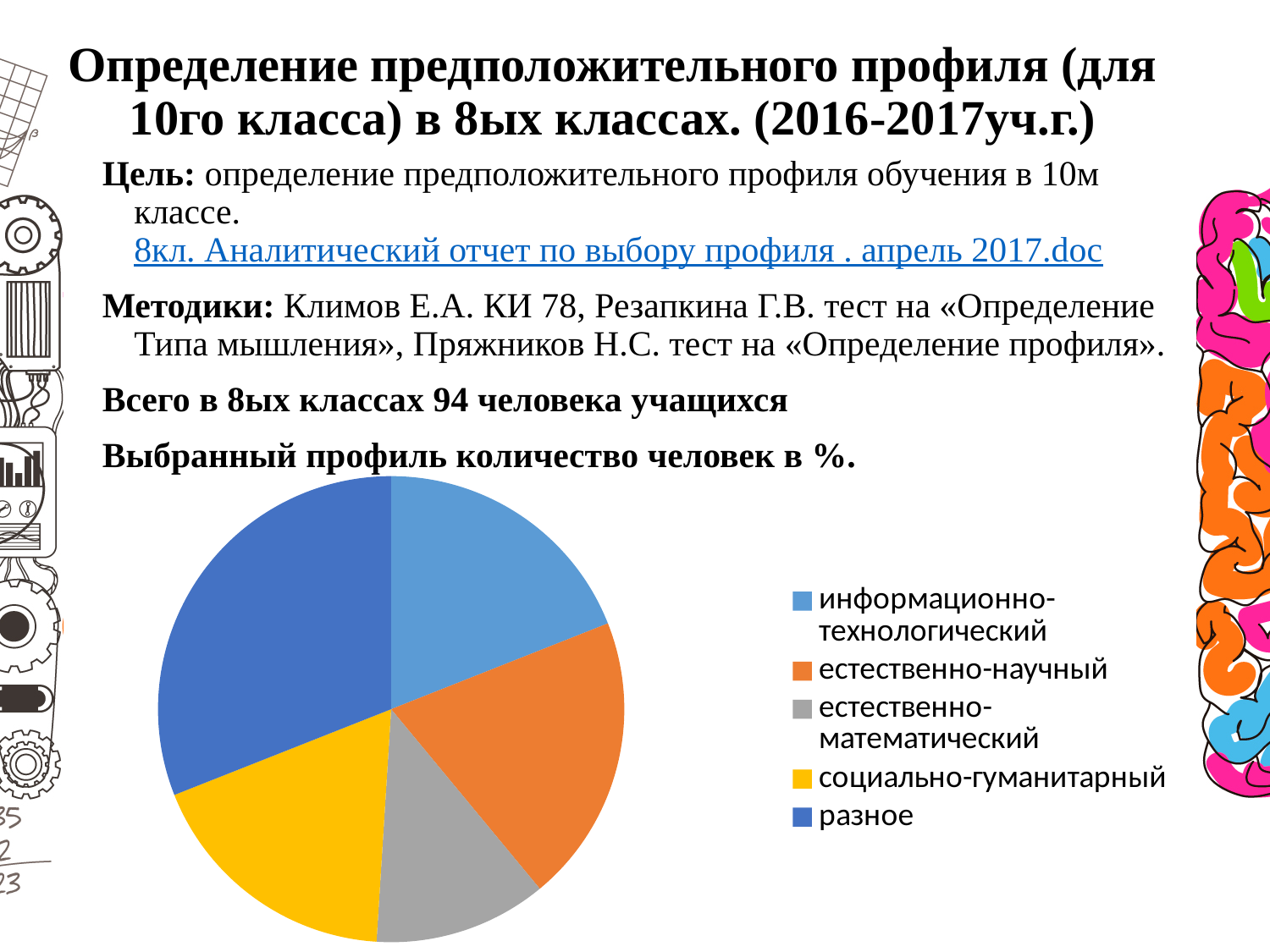
What kind of chart is shown on the slide? pie chart Which category has the smallest slice in the pie chart? естественно-математический Which slice is larger: социально-гуманитарный or разное? разное Which slice is larger: информационно-технологический or естественно-математический? информационно-технологический Which slice is larger: разное or естественно-математический? разное How many entries does the legend of the pie chart list? 5 Which colour represents социально-гуманитарный in the pie chart? yellow Which category has the largest slice in the pie chart? разное How many slices does the pie chart have? 5 Which category is shown in gray in the pie chart? естественно-математический